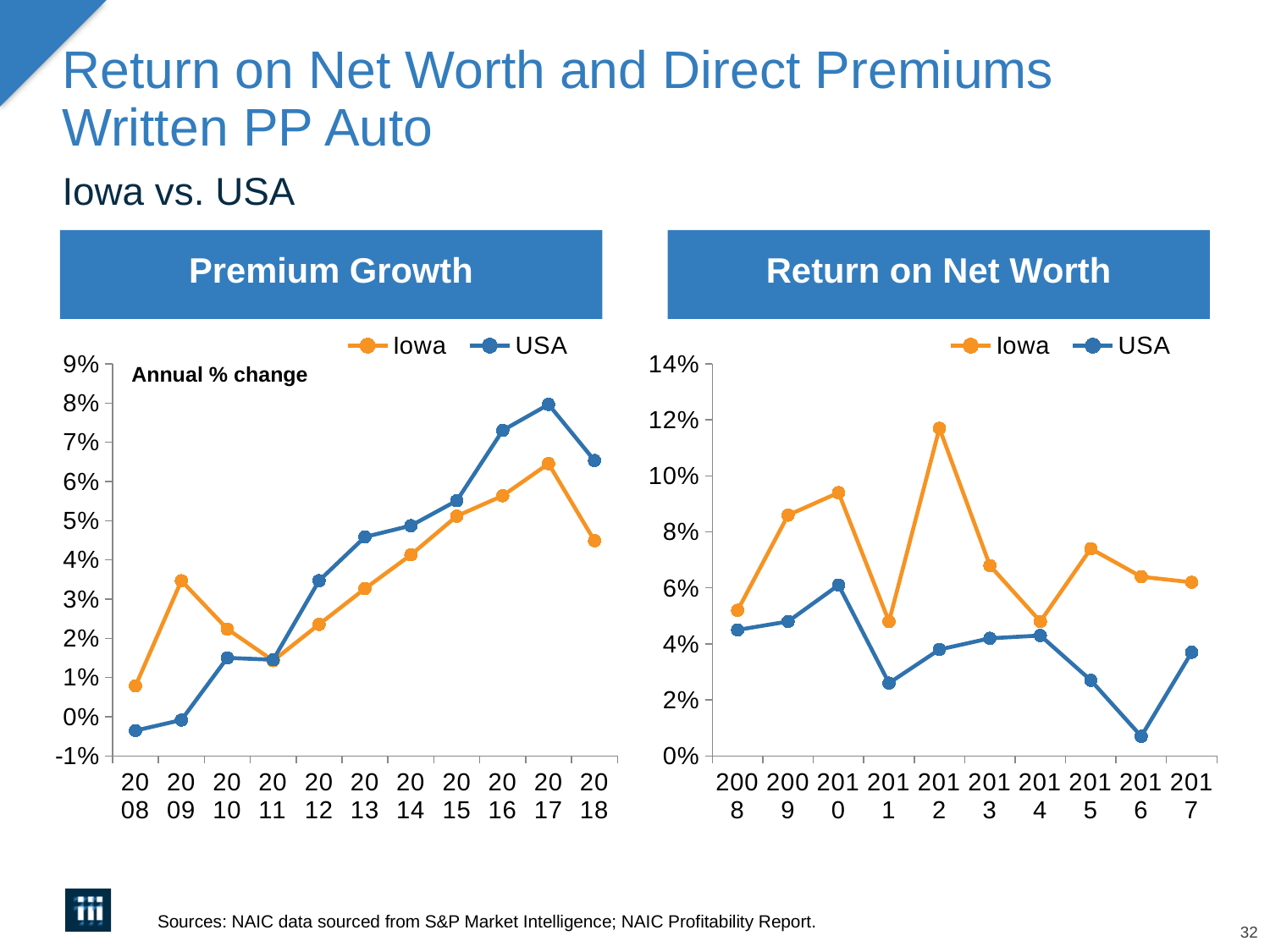
In the Return on Net Worth chart, in which year does the Iowa series peak? 2012 In the Return on Net Worth chart, which series has the larger value in 2012, Iowa or USA? Iowa What type of chart is the Premium Growth chart? Line chart How many years are plotted on the x axis of the Return on Net Worth chart? 10 How many years are plotted on the x axis of the Premium Growth chart? 11 How many series does the legend of the Return on Net Worth chart list? 2 In the Return on Net Worth chart, is the Iowa value for 2012 greater or less than 10%? greater In the Premium Growth chart, in which year does the USA series reach its highest value? 2017 In the Return on Net Worth chart, in which year is the USA series at its lowest? 2016 In the Premium Growth chart, is the USA value for 2017 greater or less than 7%? greater In the Premium Growth chart, does the USA series generally rise or fall from 2008 to 2017? Rise In the Premium Growth chart, in which year is the USA series at its lowest value? 2008